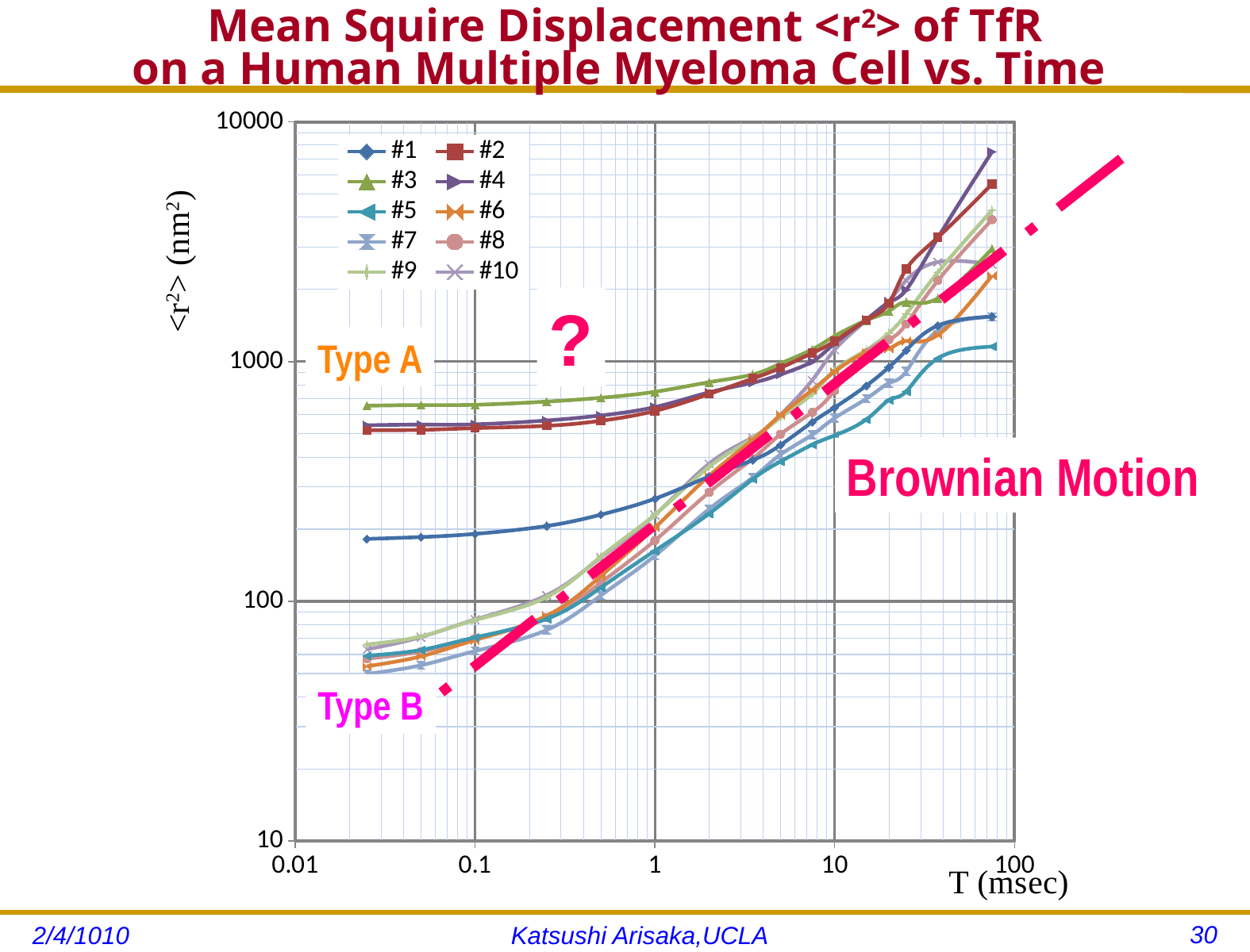
What kind of chart is shown on the slide? line chart At T = 0.1 msec, which series has the larger value, #1 or #5? #1 Is the value for series #1 at T = 0.1 msec greater or less than 1000? less At T = 0.1 msec, which series has the larger value, #3 or #1? #3 How many series does the legend list? 10 Which series has the highest value at the smallest T plotted? #3 Is the value for series #2 at T = 1 msec greater or less than 1000? less Which series reaches the highest value at the largest T plotted? #4 Is the value for series #5 at T = 0.1 msec greater or less than 100? less Do the <r²> values rise or fall as T increases along the x axis? rise What is the label on the x axis? T (msec)